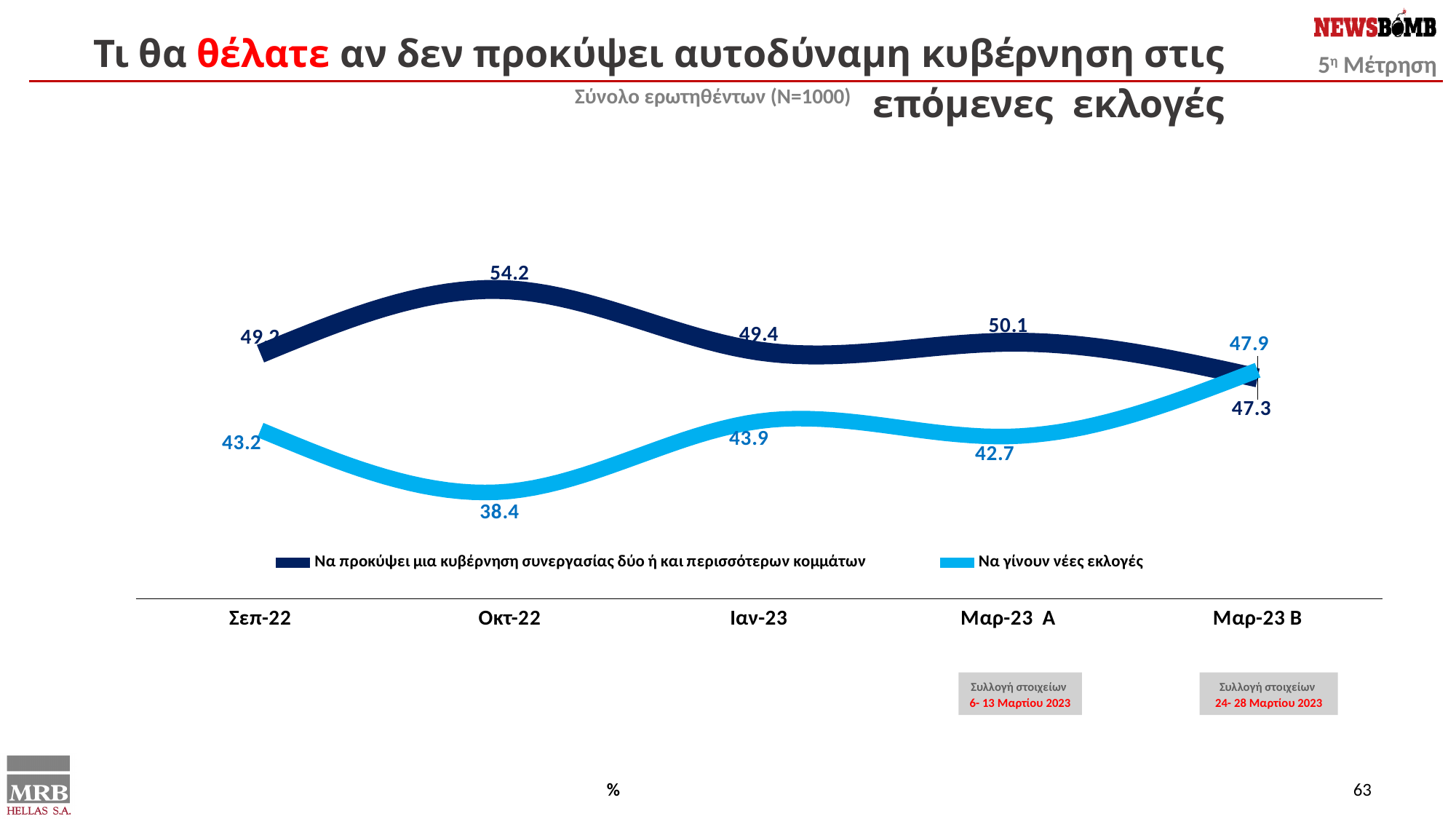
At which time point does 'Να γίνουν νέες εκλογές' have its lowest value? Οκτ-22 At which time point does 'Να προκύψει μια κυβέρνηση συνεργασίας δύο ή και περισσότερων κομμάτων' reach its highest value? Οκτ-22 What is the value for 'Να γίνουν νέες εκλογές' at Οκτ-22? 38.4 What is the value for 'Να προκύψει μια κυβέρνηση συνεργασίας δύο ή και περισσότερων κομμάτων' at Οκτ-22? 54.2 What kind of chart is shown on the slide? Line chart At Μαρ-23 Α, which series has the larger value? Να προκύψει μια κυβέρνηση συνεργασίας δύο ή και περισσότερων κομμάτων What is the difference between the two series at Οκτ-22? 15.8 What is the value for 'Να γίνουν νέες εκλογές' at Μαρ-23 Β? 47.9 How many time points are shown on the x axis? 5 Does the value for 'Να γίνουν νέες εκλογές' rise or fall from Μαρ-23 Α to Μαρ-23 Β? Rise What is the value for 'Να προκύψει μια κυβέρνηση συνεργασίας δύο ή και περισσότερων κομμάτων' at Ιαν-23? 49.4 How many series does the legend list? 2